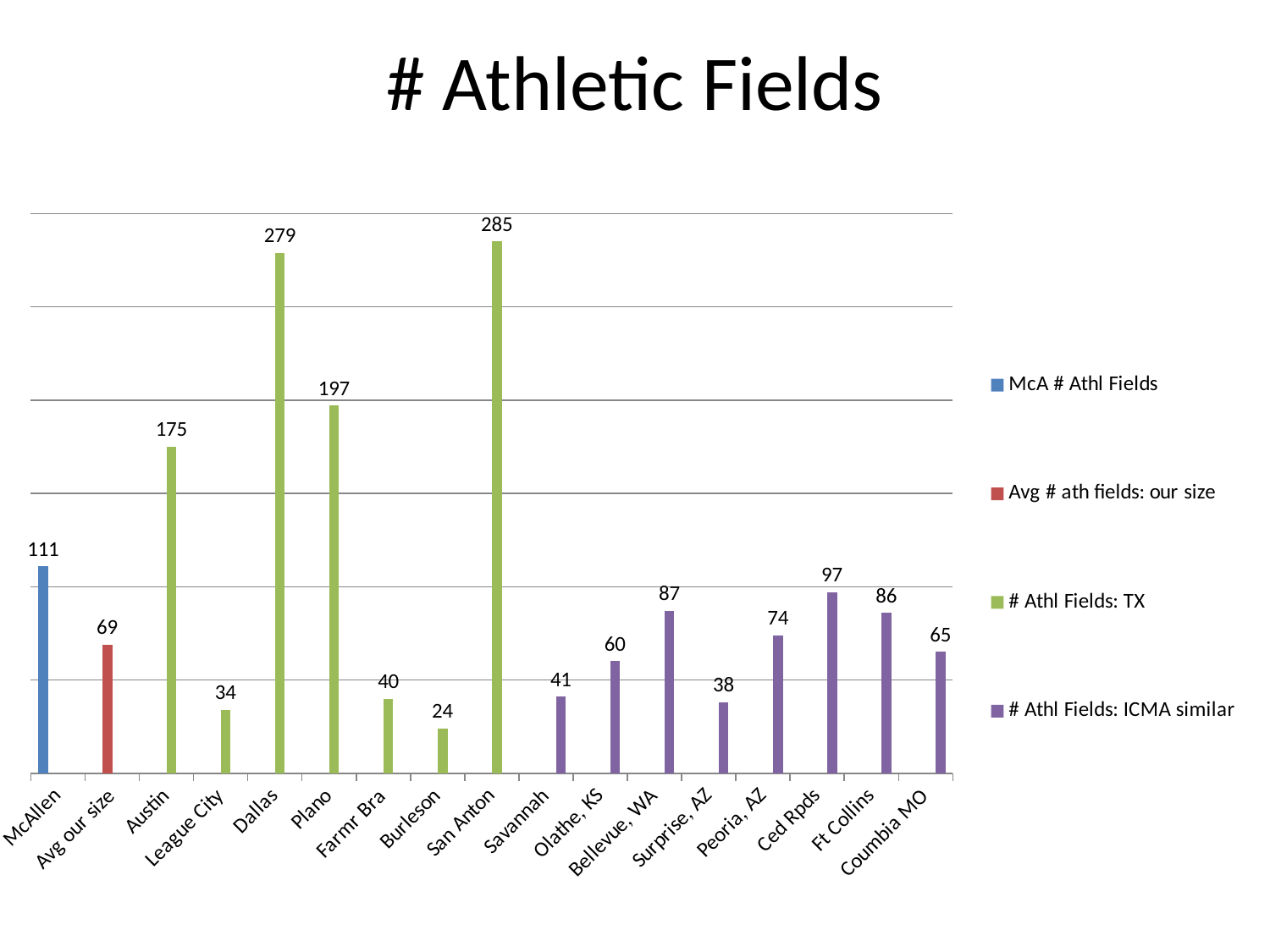
What is the difference between the values for San Anton and Dallas? 6 What is the value for McAllen? 111 What kind of chart is this? bar chart How many series does the legend list? 4 Which category has the lowest value? Burleson Which is larger, the value for Ced Rpds or the value for Ft Collins? Ced Rpds What is the title of the chart? # Athletic Fields How many categories are shown on the x axis? 17 What is the value for Bellevue, WA? 87 What is the value for Dallas? 279 What is the difference between the values for McAllen and Avg our size? 42 Which category has the highest value? San Anton